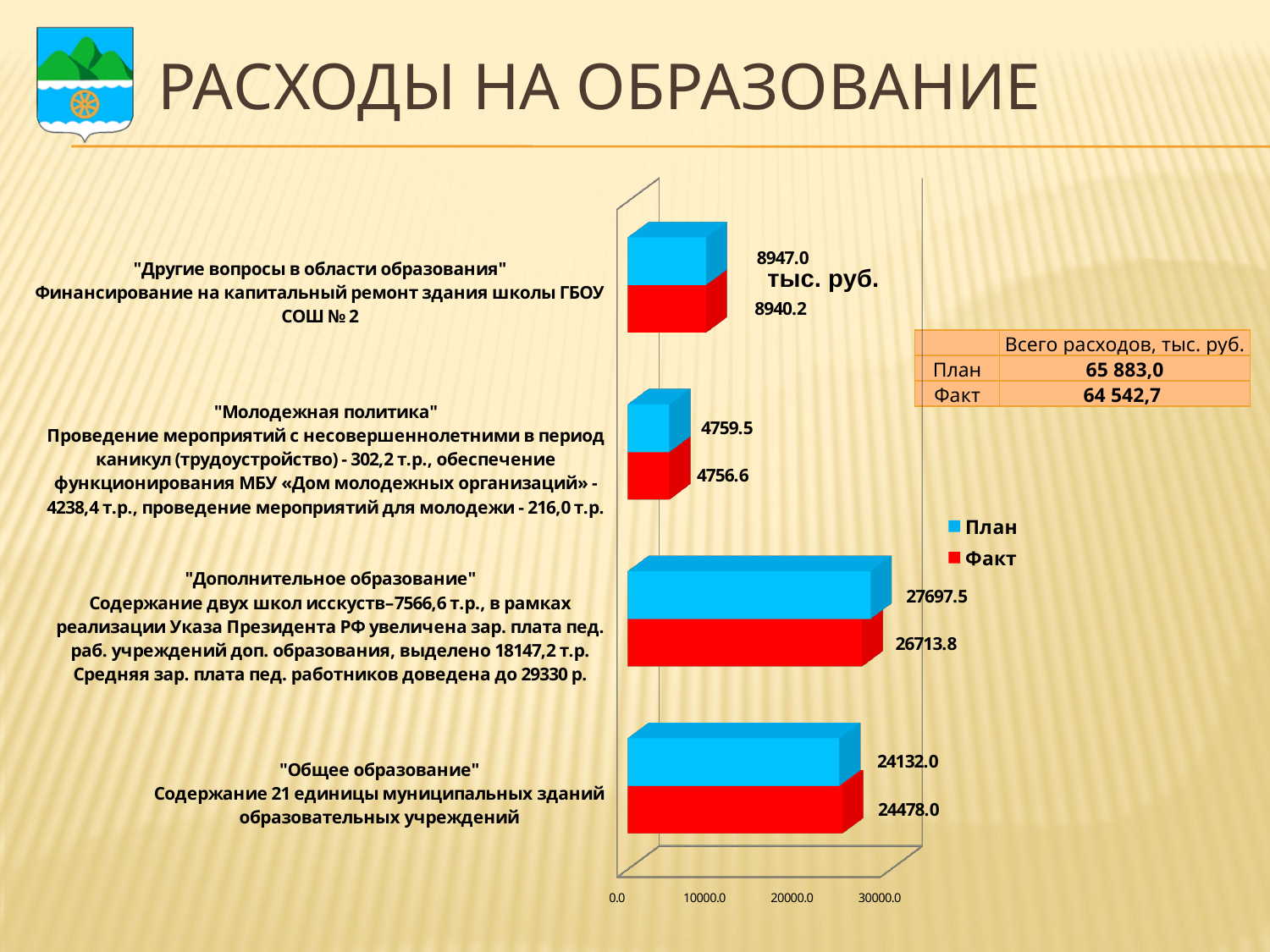
What is the План value for "Другие вопросы в области образования"? 8947.0 What is the Факт value for "Общее образование"? 24478.0 What kind of chart is shown on the slide? bar chart What is the План value for "Дополнительное образование"? 27697.5 How many series does the legend list? 2 Which category has the highest План value? "Дополнительное образование" Is the Факт value for "Дополнительное образование" greater or less than 20000.0? greater For "Общее образование", which is larger: the План value or the Факт value? Факт What is the Факт value for "Молодежная политика"? 4756.6 How many categories are shown in the chart? 4 What is the difference between the План and Факт values for "Дополнительное образование"? 983.7 Which category has the lowest Факт value? "Молодежная политика"